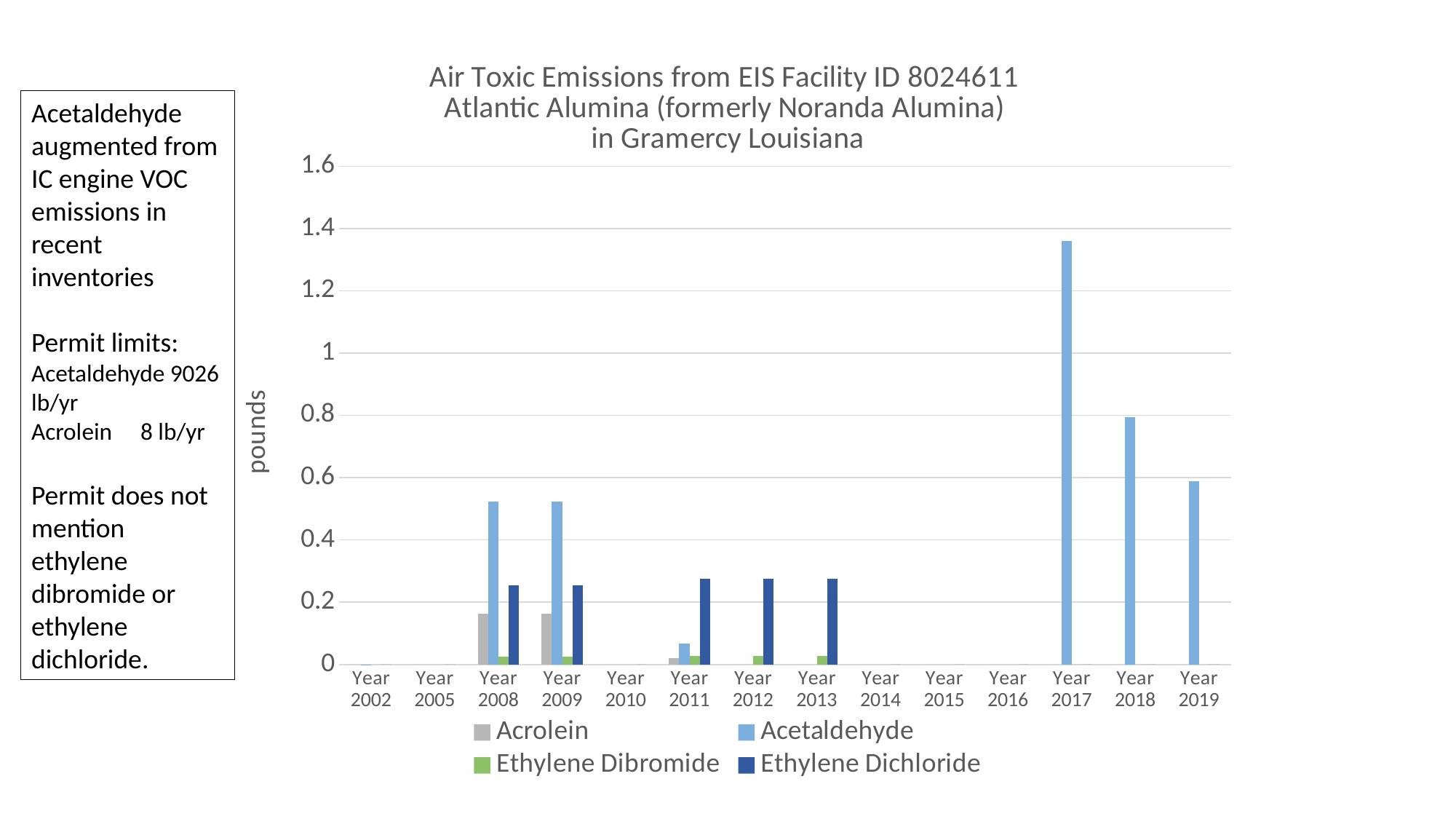
How many series does the legend list? 4 In which year is the Acetaldehyde value highest? Year 2017 Is the Acrolein value for Year 2008 greater or less than 0.2? less Is the Acetaldehyde value for Year 2018 greater or less than 1? less Do the Acetaldehyde values rise or fall from Year 2017 to Year 2019? fall Is the Ethylene Dichloride value for Year 2011 greater or less than 0.2? greater Which is larger, the Acetaldehyde value for Year 2017 or for Year 2018? Year 2017 What kind of chart is shown on the slide? bar chart How many year categories are shown on the x axis? 14 What is the label on the y axis of the chart? pounds